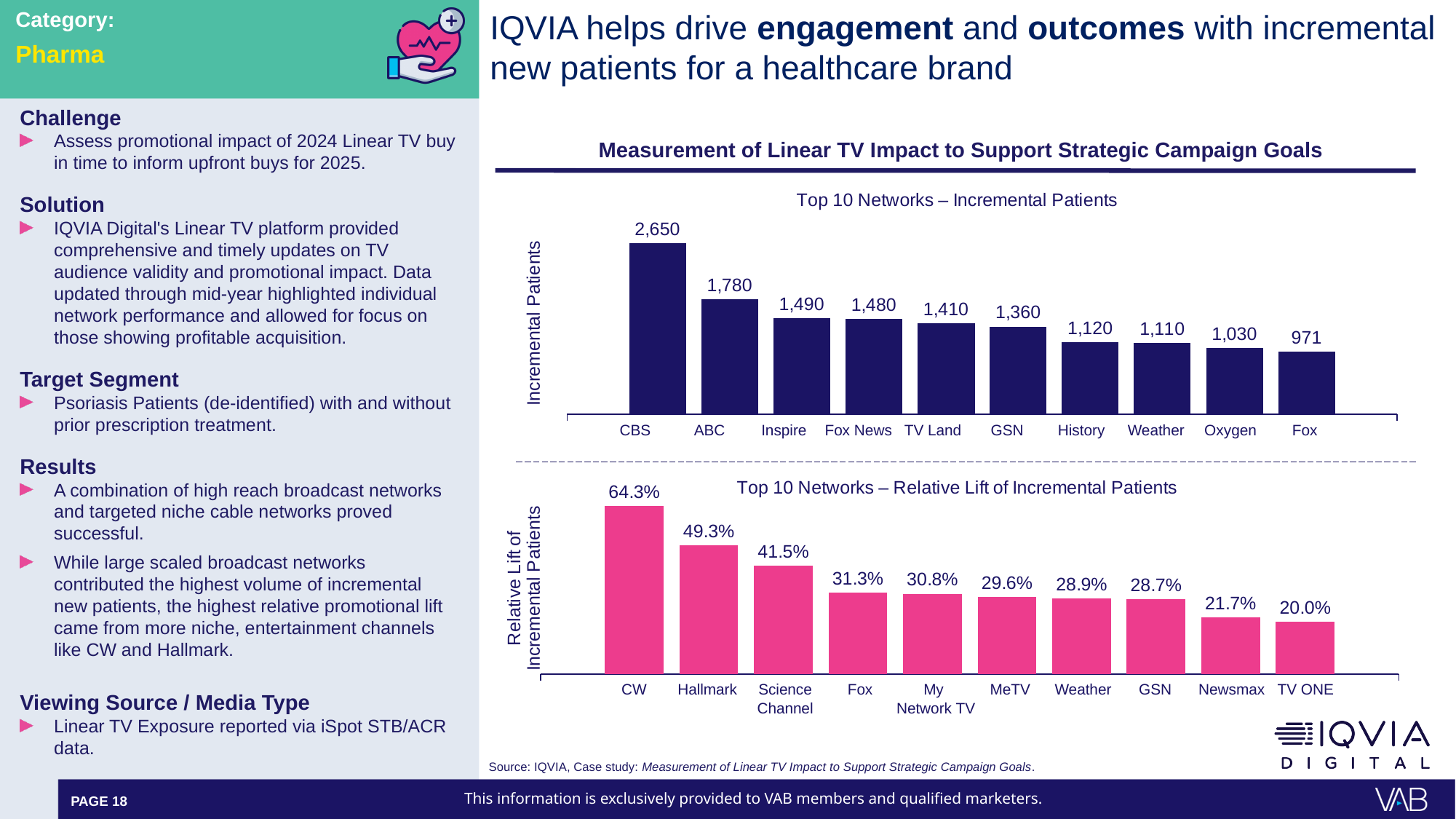
In the 'Top 10 Networks – Incremental Patients' chart, what is the value for CBS? 2,650 In the 'Top 10 Networks – Relative Lift of Incremental Patients' chart, which is larger, Science Channel or Fox? Science Channel In the 'Top 10 Networks – Incremental Patients' chart, what is the value for Weather? 1,110 In the 'Top 10 Networks – Incremental Patients' chart, which network has the lowest value? Fox In the 'Top 10 Networks – Relative Lift of Incremental Patients' chart, which network has the highest value? CW In the 'Top 10 Networks – Incremental Patients' chart, what is the difference between CBS and ABC? 870 In the 'Top 10 Networks – Relative Lift of Incremental Patients' chart, what is the difference between CW and Hallmark? 15.0% What kind of chart is the 'Top 10 Networks – Relative Lift of Incremental Patients' chart? Bar chart In the 'Top 10 Networks – Relative Lift of Incremental Patients' chart, what is the value for Hallmark? 49.3% In the 'Top 10 Networks – Incremental Patients' chart, how many networks are shown? 10 In the 'Top 10 Networks – Relative Lift of Incremental Patients' chart, what is the value for TV ONE? 20.0% In the 'Top 10 Networks – Incremental Patients' chart, do the values rise or fall from left to right? Fall